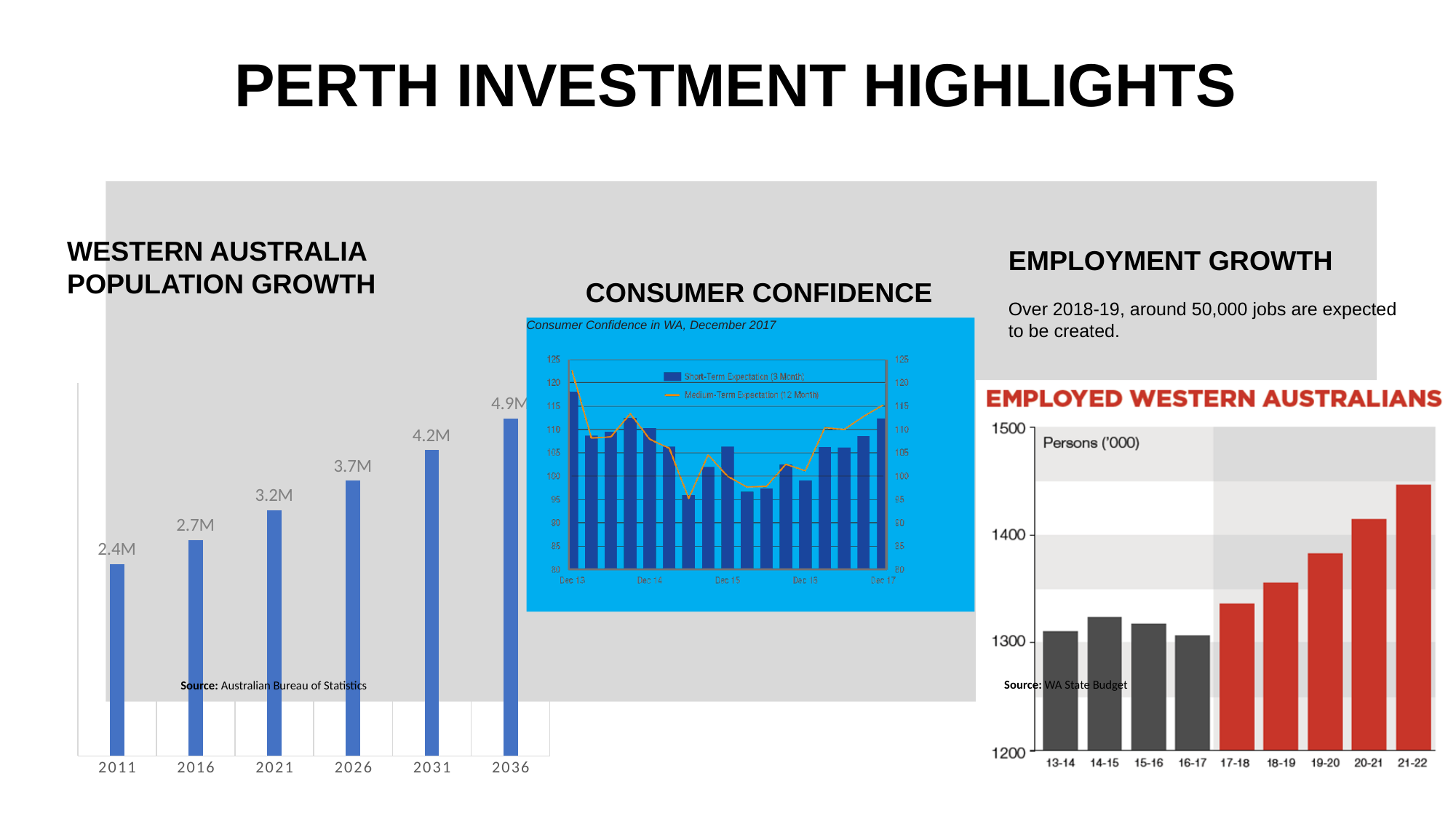
In the Western Australia Population Growth chart, what kind of chart is used? bar chart In the Consumer Confidence in WA chart, which series is drawn as a line? Medium-Term Expectation (12 Month) In the Western Australia Population Growth chart, which year has the lowest value? 2011 In the Western Australia Population Growth chart, do the values rise or fall from 2011 to 2036? rise In the Western Australia Population Growth chart, what is the value for 2011? 2.4M In the Employed Western Australians chart, is the value for 21-22 greater or less than 1400? greater In the Consumer Confidence in WA chart, how many series does the legend list? 2 In the Employed Western Australians chart, which year has the highest value? 21-22 In the Western Australia Population Growth chart, what is the value for 2036? 4.9M In the Western Australia Population Growth chart, how many years are shown on the x axis? 6 In the Western Australia Population Growth chart, which year has the highest value? 2036 In the Employed Western Australians chart, how many years are shown on the x axis? 9